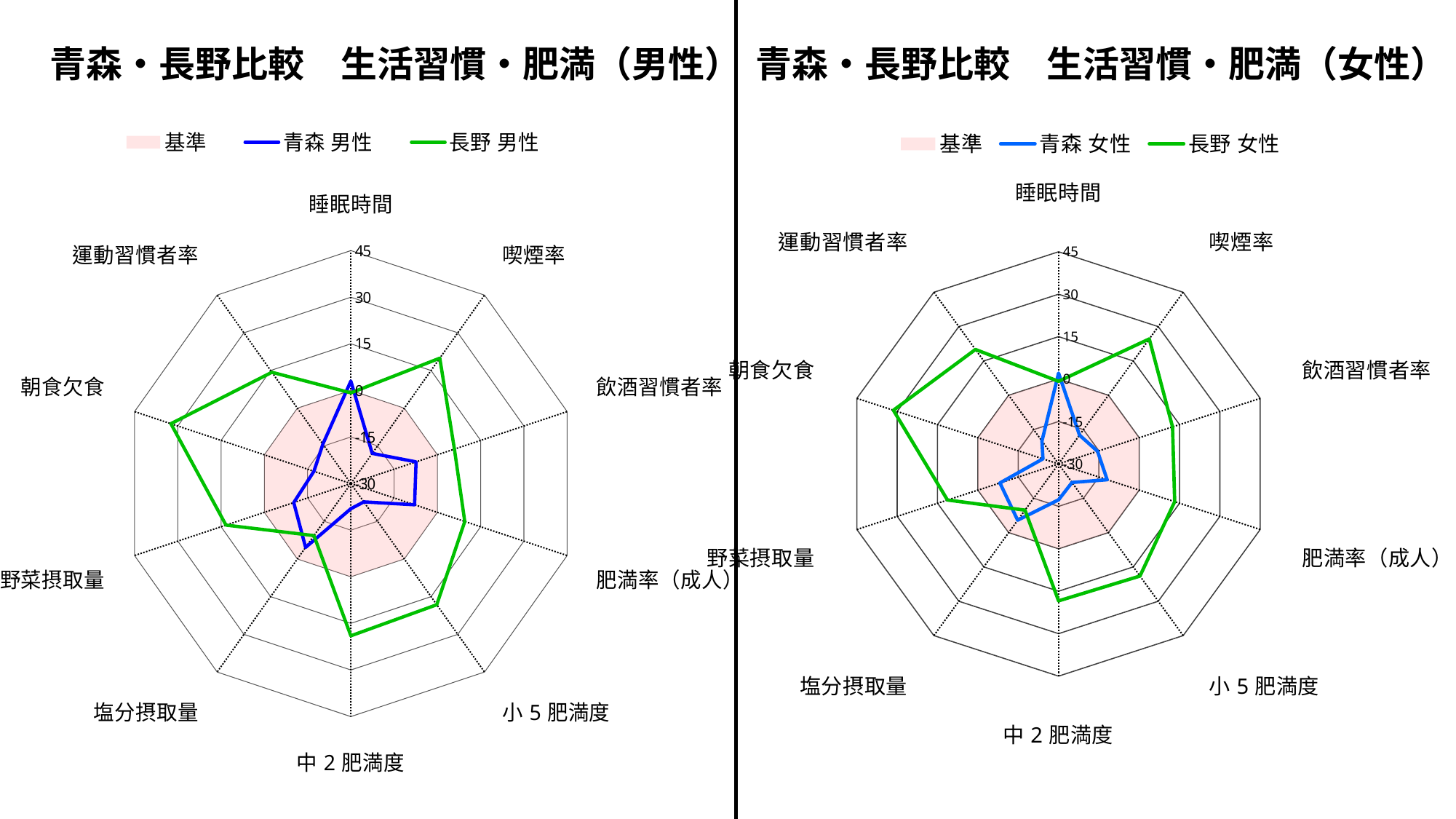
In the left chart (男性), how many categories are plotted around the radar? 10 In the left chart (男性), which series has the larger value for 朝食欠食, 青森 男性 or 長野 男性? 長野 男性 What kind of chart is shown on the left side of the slide? Radar chart In the left chart (男性), how many series does the legend list? 3 In the right chart (女性), which series is drawn in green? 長野 女性 In the right chart (女性), how many categories are plotted around the radar? 10 In the right chart (女性), how many series does the legend list? 3 What kind of chart is shown on the right side of the slide? Radar chart In the right chart (女性), which series has the larger value for 飲酒習慣者率, 青森 女性 or 長野 女性? 長野 女性 In the left chart (男性), is the value of 長野 男性 for 睡眠時間 greater or less than 15? less In the right chart (女性), is the value of 長野 女性 for 喫煙率 greater or less than 0? greater What is the title of the chart on the left? 青森・長野比較 生活習慣・肥満（男性）